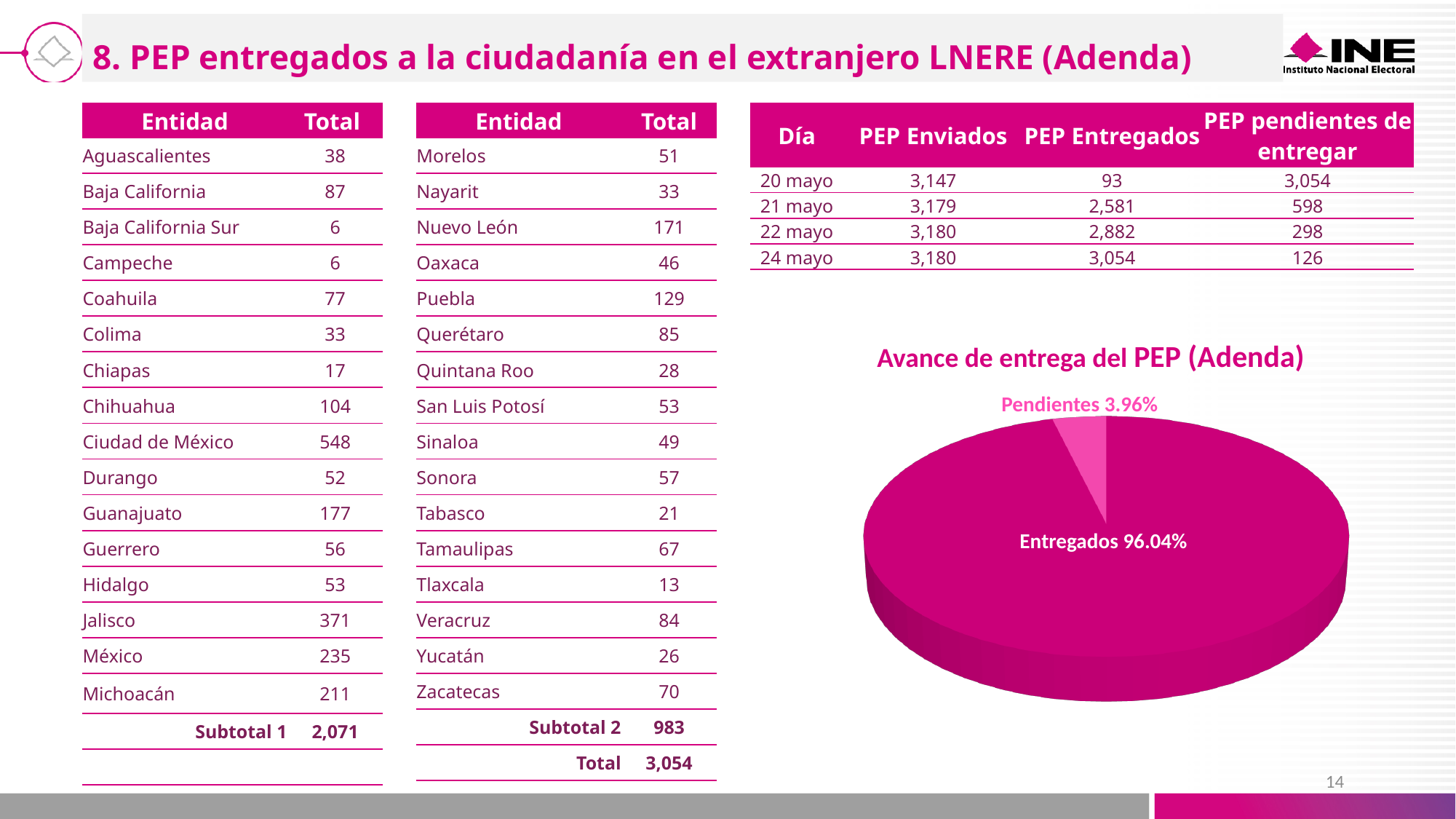
Which slice of the pie chart is the smallest? Pendientes What is the title of the pie chart? Avance de entrega del PEP (Adenda) In the pie chart, what share is labelled for Pendientes? 3.96% In the pie chart, what share is labelled for Entregados? 96.04% What kind of chart is shown under the title "Avance de entrega del PEP (Adenda)"? pie chart How many slices does the pie chart have? 2 What is the difference in percentage points between the Entregados and Pendientes slices of the pie chart? 92.08 Which slice of the pie chart is the largest? Entregados Is the Pendientes slice of the pie chart greater or less than 5%? less In the pie chart, which is larger: Entregados or Pendientes? Entregados Is the Entregados slice of the pie chart greater or less than 90%? greater